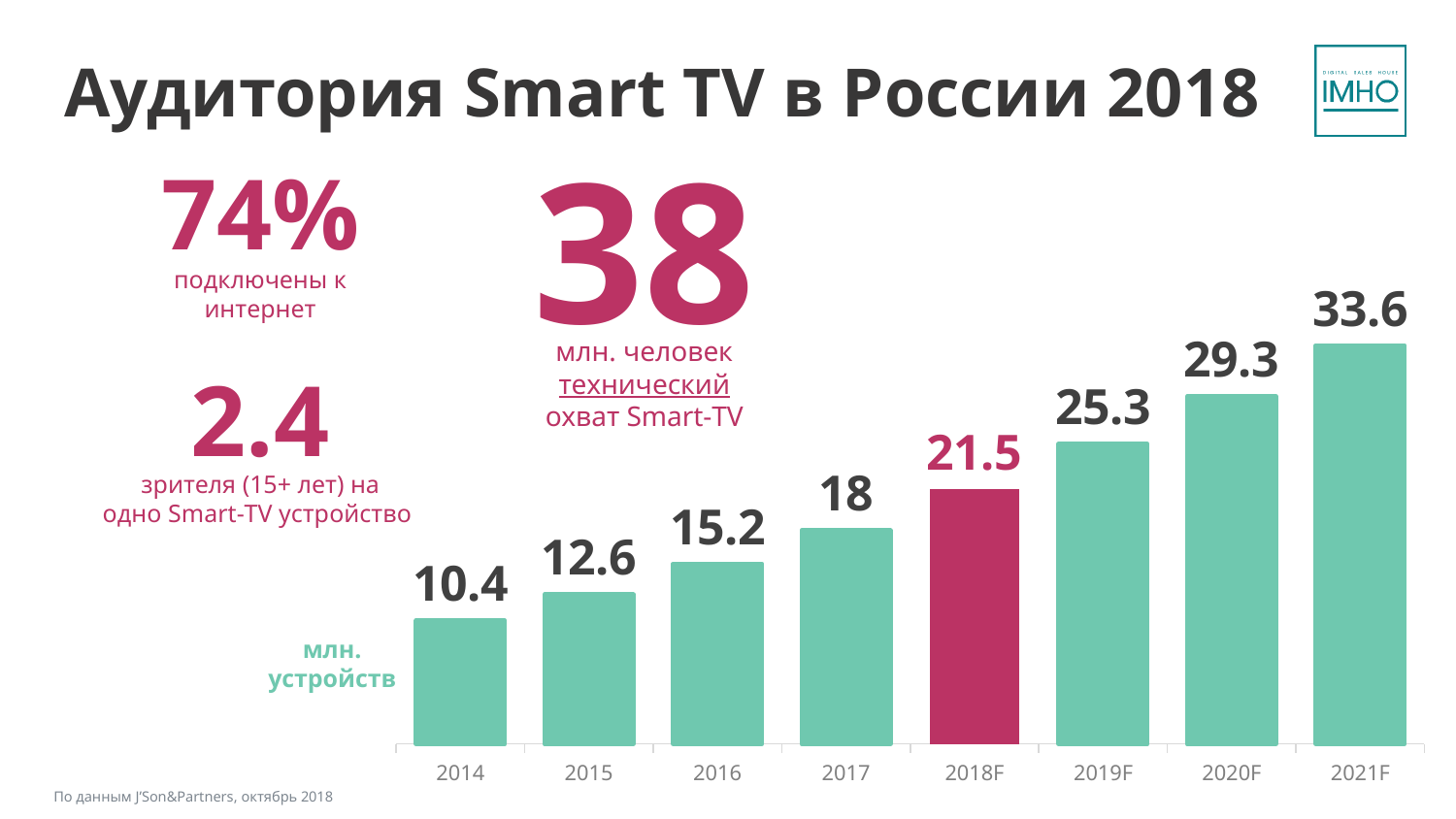
What is the value for 2021F in the bar chart? 33.6 What is the difference between the values for 2018F and 2017? 3.5 What is the value for 2014 in the bar chart? 10.4 Do the values rise or fall from 2014 to 2021F? rise What is the value for 2018F in the bar chart? 21.5 What is the difference between the values for 2021F and 2014? 23.2 Which bar in the chart is coloured differently (magenta) from the others? 2018F Which year has the lowest value in the bar chart? 2014 Which year has the highest value in the bar chart? 2021F How many years are shown on the x axis of the bar chart? 8 What kind of chart is shown on the slide? bar chart Which is larger, the value for 2016 or the value for 2019F? 2019F